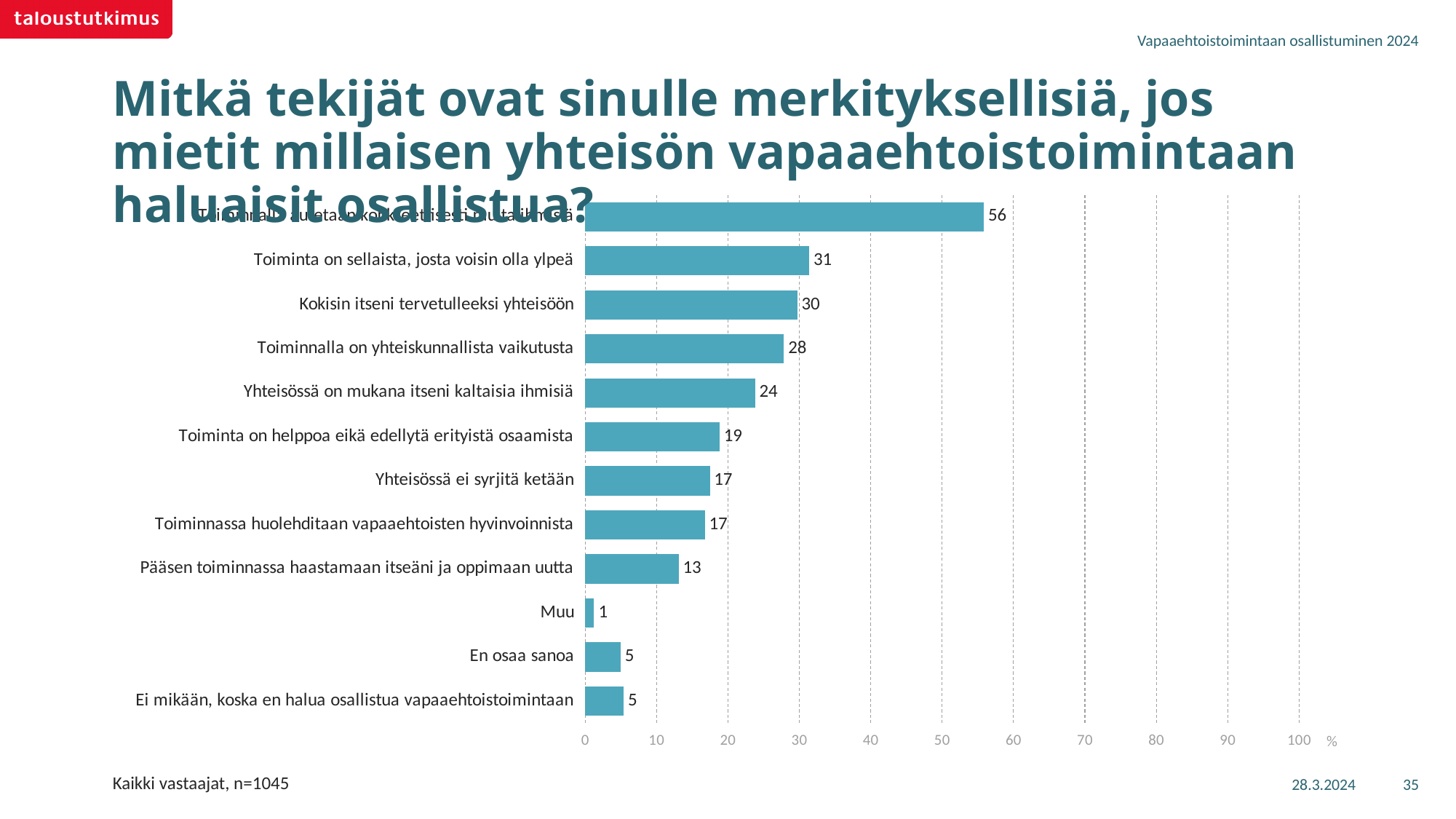
What is the value for "Toiminta on sellaista, josta voisin olla ylpeä"? 31 What is the highest value shown in the chart? 56 Which is larger: the value for "Toiminta on sellaista, josta voisin olla ylpeä" or the value for "Yhteisössä on mukana itseni kaltaisia ihmisiä"? Toiminta on sellaista, josta voisin olla ylpeä What is the value for "Yhteisössä on mukana itseni kaltaisia ihmisiä"? 24 What is the sample size stated below the chart? n=1045 What is the value for "Kokisin itseni tervetulleeksi yhteisöön"? 30 What is the value for "Muu"? 1 What is the value for "Pääsen toiminnassa haastamaan itseäni ja oppimaan uutta"? 13 Which category has the lowest value? Muu What kind of chart is shown on the slide? Bar chart How many categories are shown in the chart? 12 What is the difference between the values for "Toiminnalla on yhteiskunnallista vaikutusta" and "Toiminta on helppoa eikä edellytä erityistä osaamista"? 9